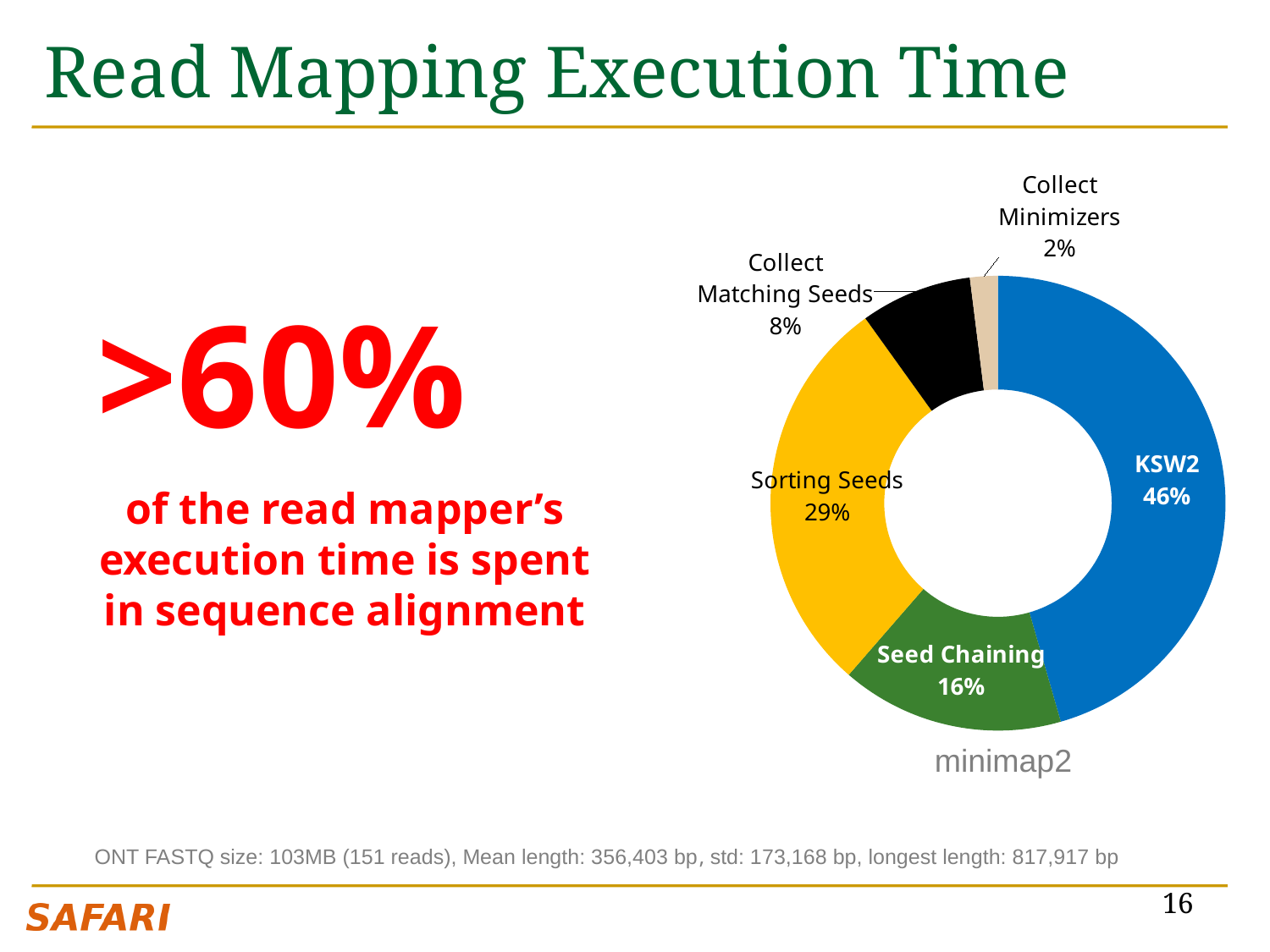
Which stage takes the largest share of execution time? KSW2 What percentage is shown for Collect Minimizers? 2% How many percentage points larger is KSW2's share than Sorting Seeds' share? 17 What kind of chart is shown on the slide? Pie (doughnut) chart Which read mapper is the chart labelled with? minimap2 Which stage takes the smallest share of execution time? Collect Minimizers What percentage of execution time does Sorting Seeds take? 29% Which has a larger share, Seed Chaining or Collect Matching Seeds? Seed Chaining What is the share for Seed Chaining? 16% How many stages are shown in the chart? 5 What percentage is shown for Collect Matching Seeds? 8% What share of minimap2's execution time is spent in KSW2? 46%